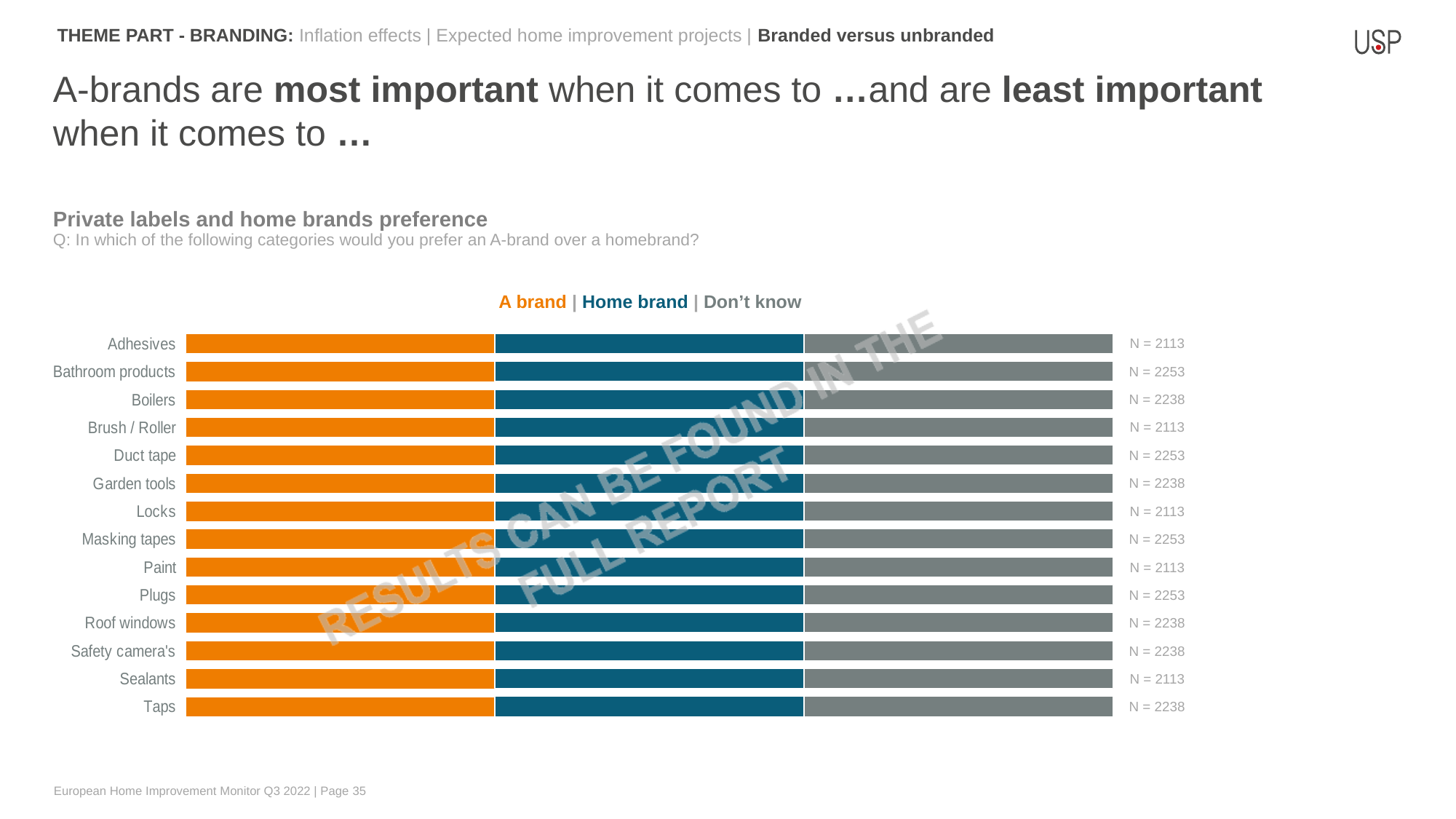
What is the sample size (N) shown for Paint? N = 2113 What is the title of the chart? Private labels and home brands preference What is the sample size (N) shown for Plugs? N = 2253 What is the sample size (N) shown for Adhesives? N = 2113 What is the sample size (N) shown for Taps? N = 2238 What kind of chart is shown on the slide? Stacked bar chart What are the three series named in the chart's legend? A brand, Home brand, Don't know What is the sample size (N) shown for Boilers? N = 2238 How many series does the chart's legend list? 3 How many product categories are listed on the chart? 14 What is the sample size (N) shown for Bathroom products? N = 2253 What is the sample size (N) shown for Roof windows? N = 2238